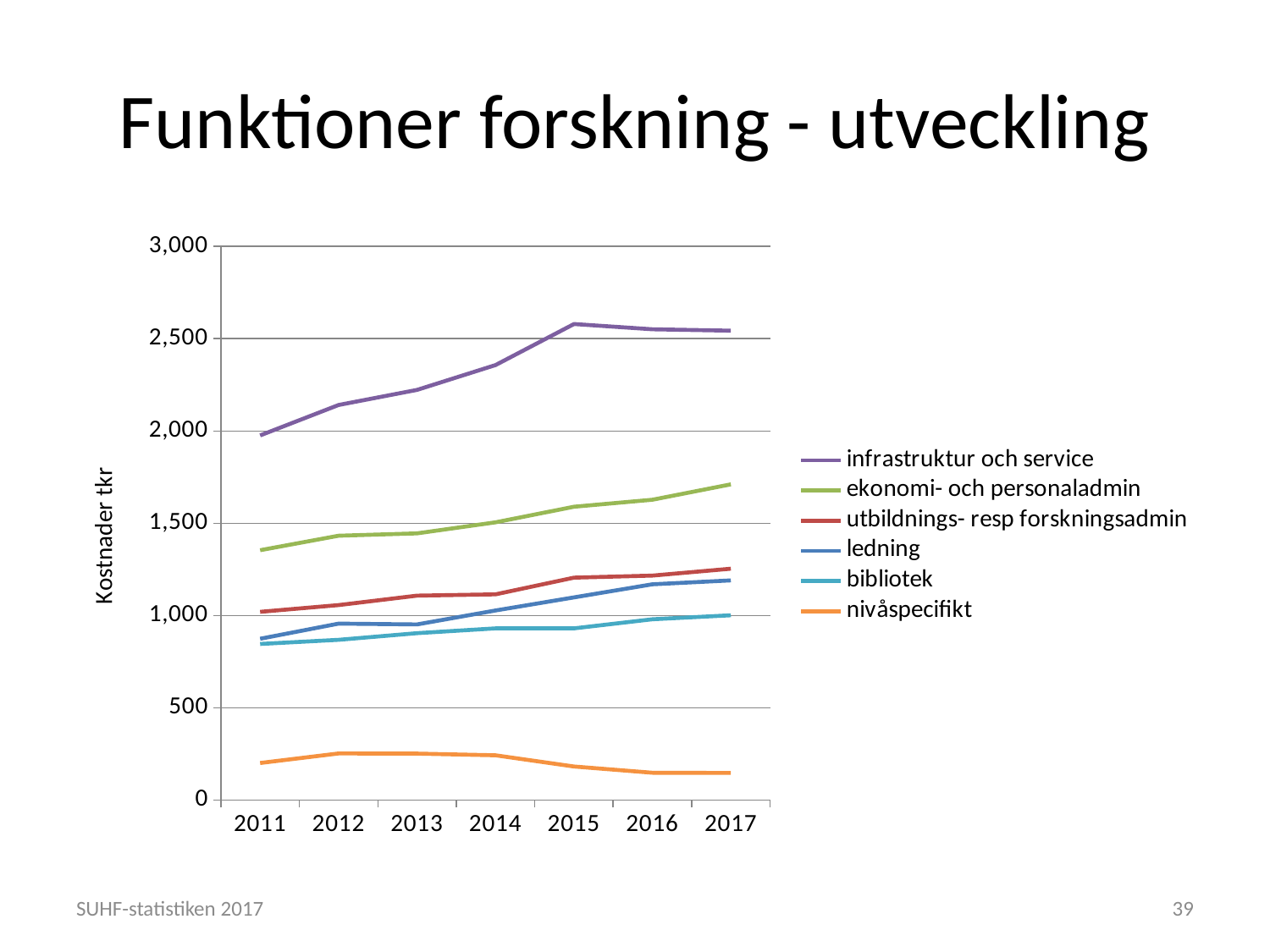
In 2017, which is larger: ledning or bibliotek? ledning Is the value for ledning in 2011 greater or less than 1,000? less How many years are shown on the x axis? 7 Is the value for infrastruktur och service in 2015 greater or less than 2,500? greater Which series has the highest values across all years? infrastruktur och service What is the label on the y axis? Kostnader tkr How many series does the legend list? 6 Which series has the lowest values across all years? nivåspecifikt What kind of chart is shown on the slide? line chart Does the infrastruktur och service series rise or fall from 2011 to 2015? rise Is the value for ekonomi- och personaladmin in 2017 greater or less than 1,500? greater